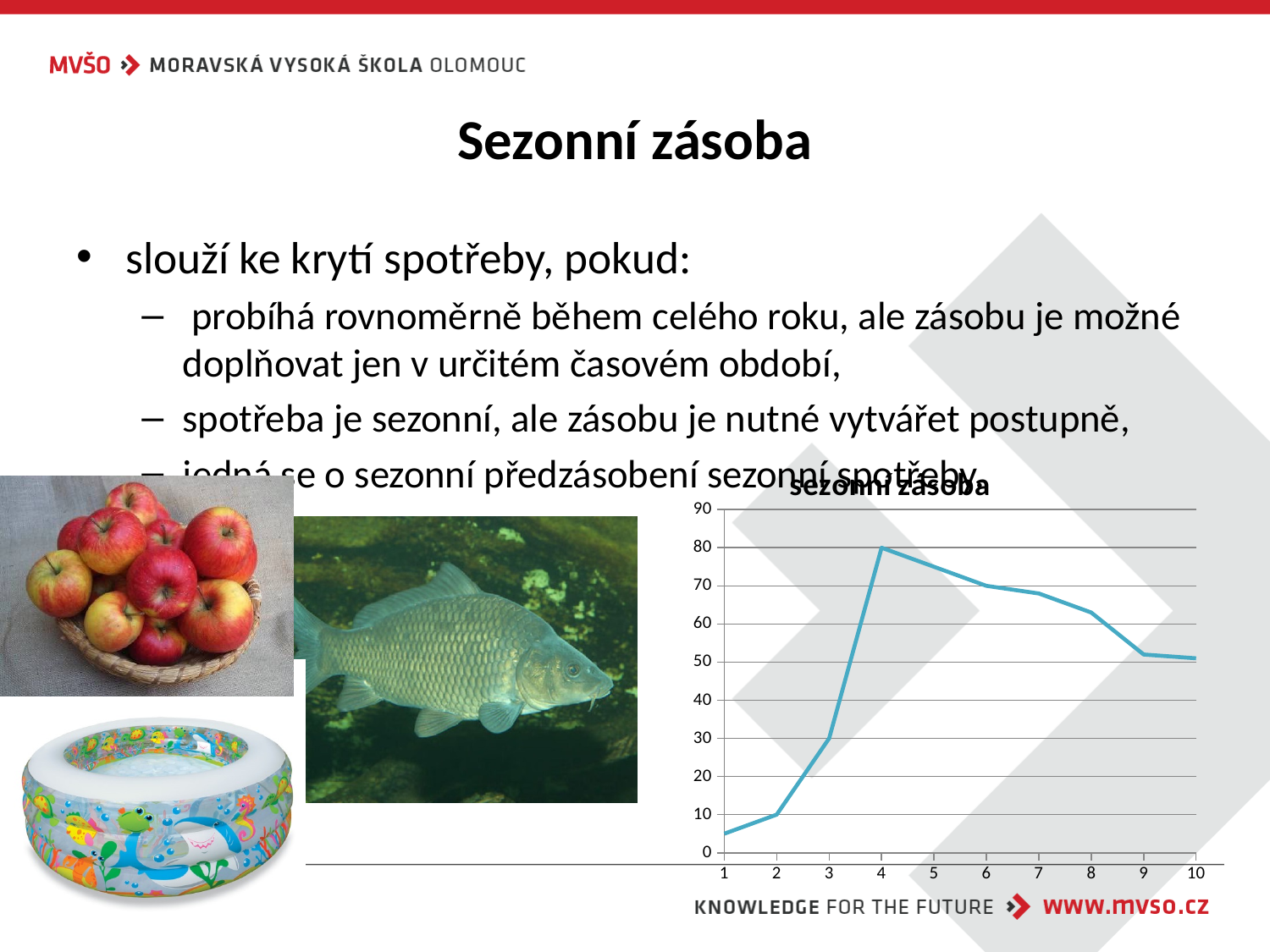
Is the value at category 1 greater or less than 10? less At which x-axis category does the line reach its highest value? 4 What kind of chart is shown on the slide? line chart Which has the larger value, category 2 or category 8? 8 Is the value at category 9 greater or less than 60? less What is the title of the chart? sezonní zásoba What is the value at category 4? 80 Do the values rise or fall from category 4 to category 10? fall At which x-axis category does the line have its lowest value? 1 Is the value at category 3 greater or less than 40? less How many points are plotted along the x axis of the chart? 10